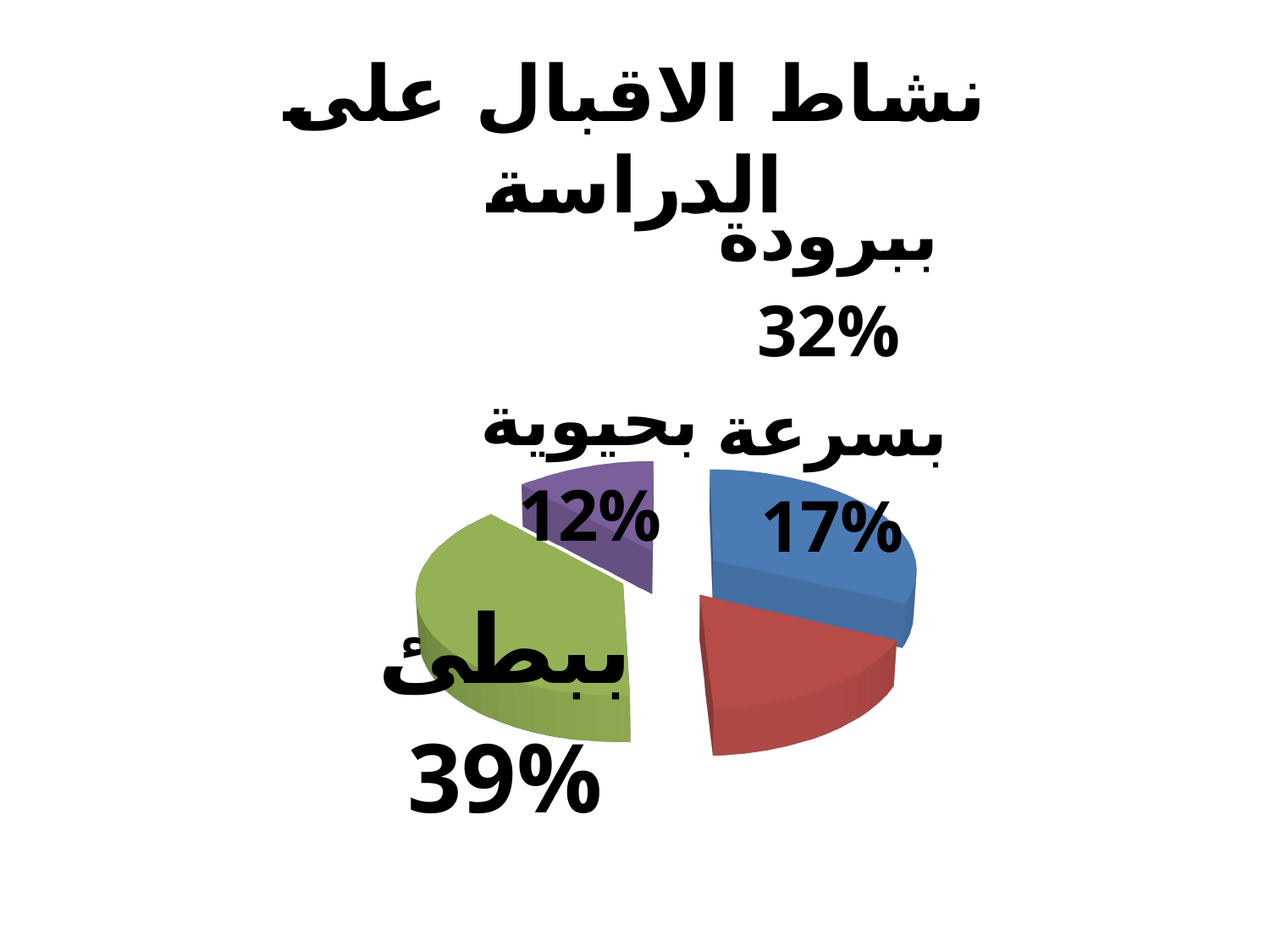
Is the value for ببرودة greater or less than 30%? greater How many slices does the pie chart have? 4 What is the smallest percentage shown on the pie chart? 12% Which is larger, the share for ببطئ or the share for ببرودة? ببطئ What kind of chart is shown on the slide? pie chart What is the title of the chart? نشاط الاقبال على الدراسة By how many percentage points does ببطئ exceed ببرودة? 7 What share of the pie does the ببطئ slice represent? 39% What percentage is shown for ببطئ? 39% Which category has the largest share of the pie? ببطئ What percentage is shown for ببرودة? 32% What colour is the slice labelled ببطئ? green